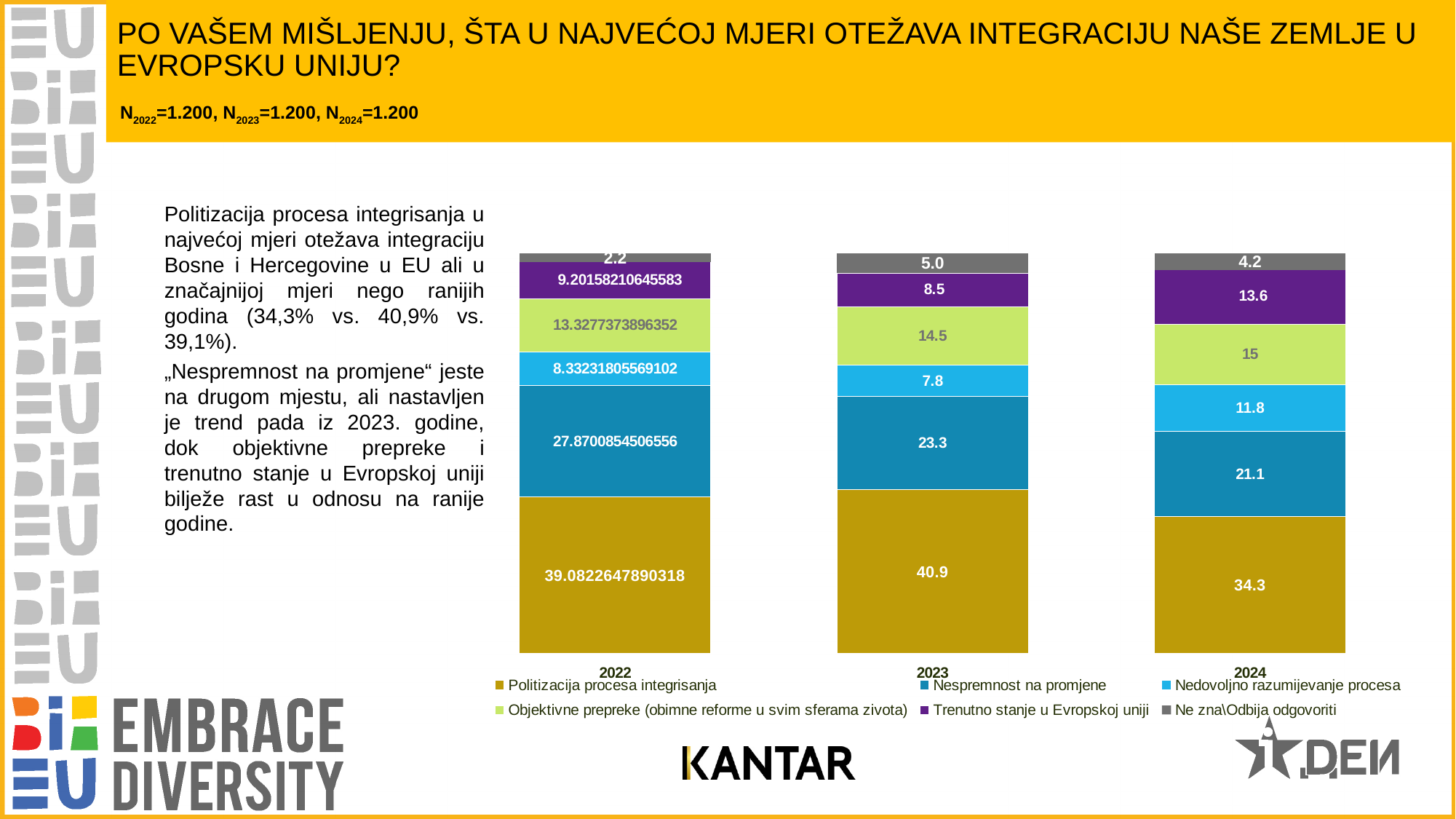
What type of chart is shown on the slide? Stacked bar chart In which year is the value for 'Nespremnost na promjene' the lowest? 2024 Does the value for 'Nespremnost na promjene' rise or fall from 2022 to 2024? Fall What is the difference between the 'Politizacija procesa integrisanja' values in 2023 and 2024? 6.6 What is the value for 'Nespremnost na promjene' in 2024? 21.1 How many years (categories) are shown on the x axis? 3 What is the value for 'Politizacija procesa integrisanja' in 2023? 40.9 What is the value for 'Ne zna\Odbija odgovoriti' in 2023? 5.0 Which is larger: 'Nedovoljno razumijevanje procesa' in 2023 or in 2024? 2024 In which year is the value for 'Politizacija procesa integrisanja' the highest? 2023 What is the value for 'Trenutno stanje u Evropskoj uniji' in 2024? 13.6 How many series does the legend list? 6